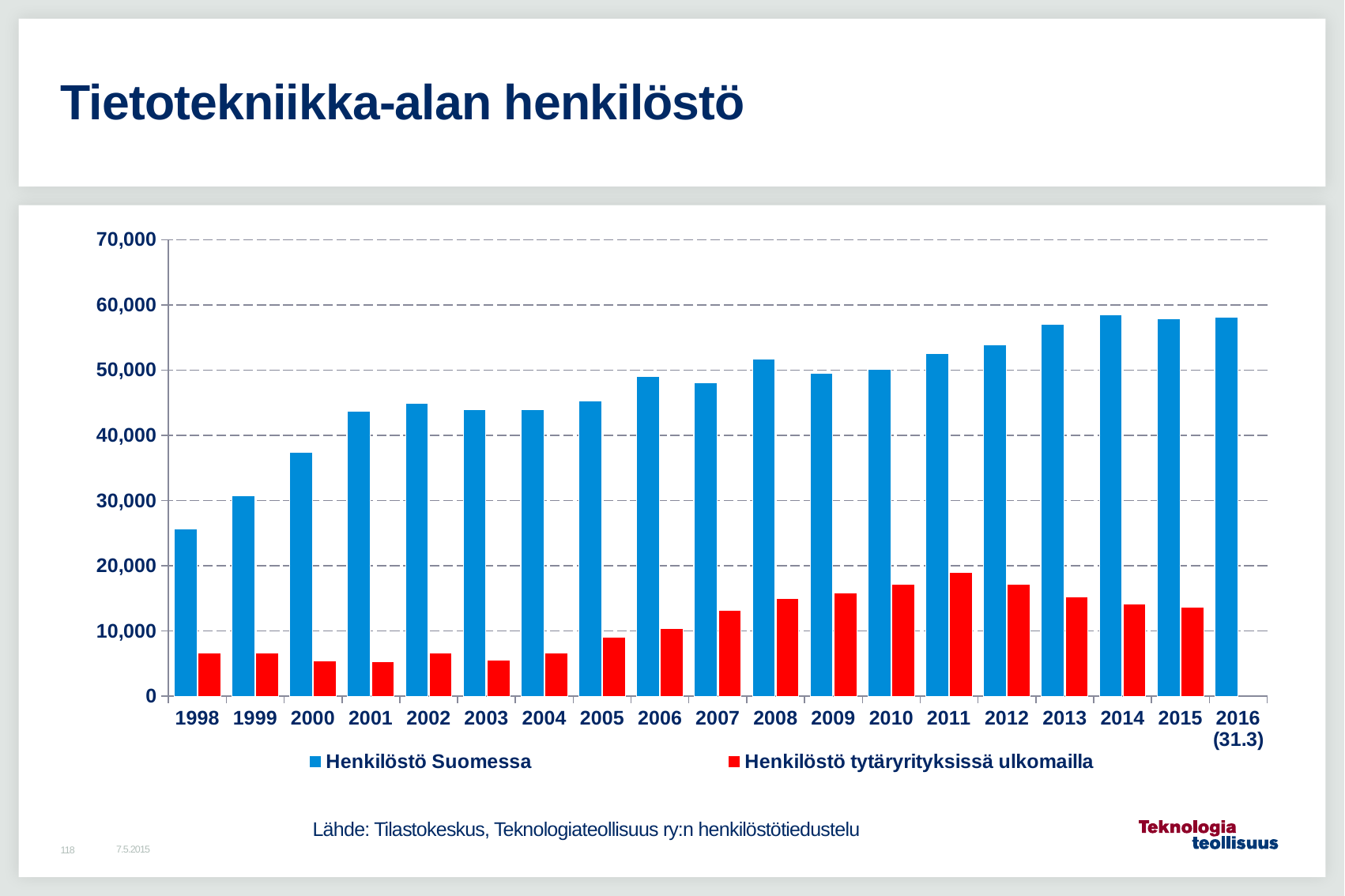
What colour are the bars for Henkilöstö tytäryrityksissä ulkomailla? red How many series does the legend list? 2 Is the value for Henkilöstö Suomessa in 1998 greater or less than 30,000? less Which is larger for Henkilöstö tytäryrityksissä ulkomailla: 2011 or 2015? 2011 Is the value for Henkilöstö tytäryrityksissä ulkomailla in 2007 greater or less than 10,000? greater Does the value for Henkilöstö Suomessa generally rise or fall from 1998 to 2016? rise Is the value for Henkilöstö tytäryrityksissä ulkomailla in 2003 greater or less than 10,000? less How many years (categories) are shown on the x axis? 19 Which year has the highest value for Henkilöstö tytäryrityksissä ulkomailla? 2011 Which year has the lowest value for Henkilöstö Suomessa? 1998 What kind of chart is shown on the slide? bar chart